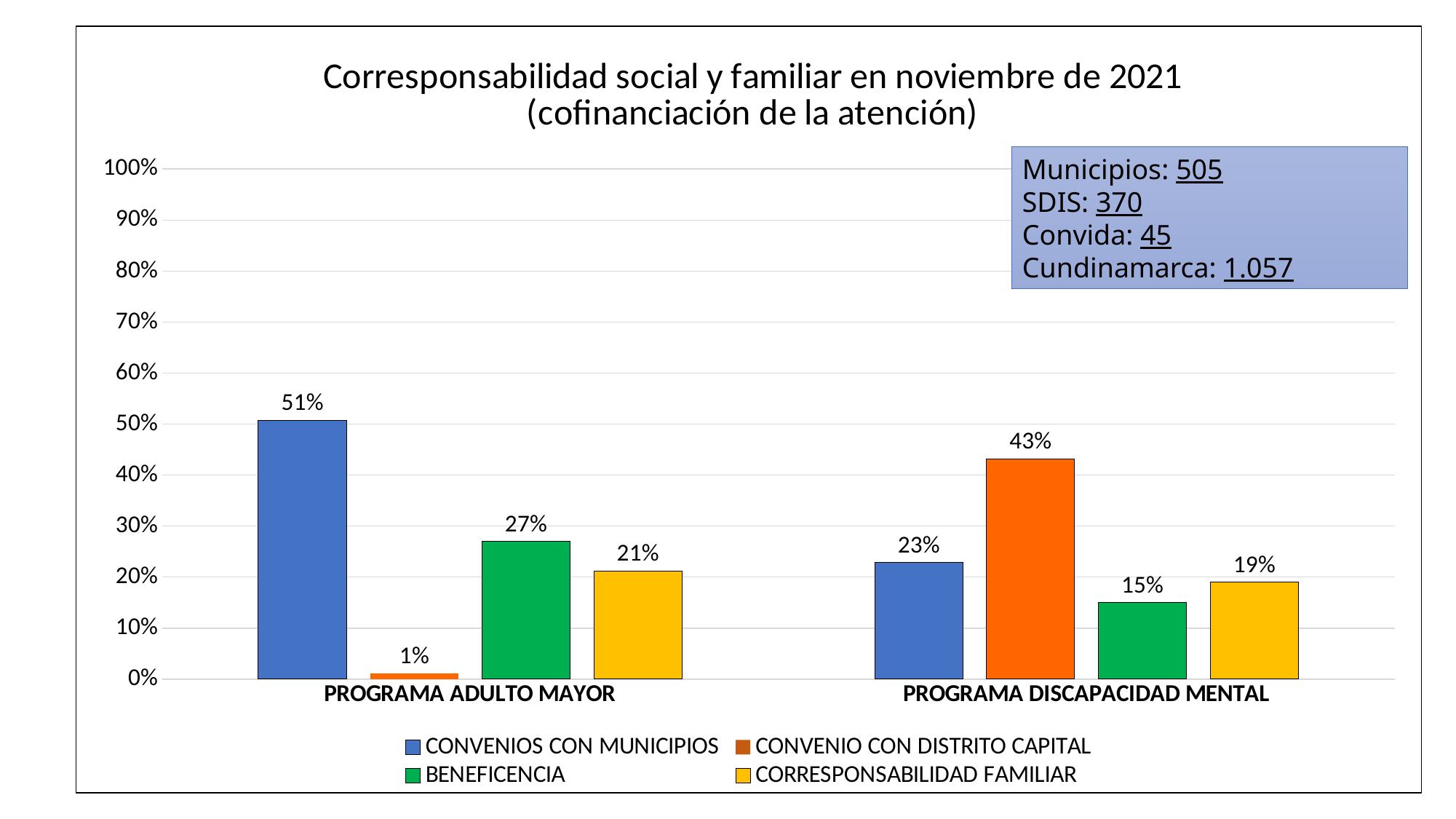
Which series has the highest value in PROGRAMA ADULTO MAYOR? CONVENIOS CON MUNICIPIOS What is the value for CONVENIOS CON MUNICIPIOS in PROGRAMA ADULTO MAYOR? 51% What is the value for CORRESPONSABILIDAD FAMILIAR in PROGRAMA DISCAPACIDAD MENTAL? 19% What is the value for CONVENIO CON DISTRITO CAPITAL in PROGRAMA DISCAPACIDAD MENTAL? 43% How many categories are shown on the x axis? 2 What is the value for BENEFICENCIA in PROGRAMA ADULTO MAYOR? 27% What is the difference between CONVENIOS CON MUNICIPIOS in PROGRAMA ADULTO MAYOR and in PROGRAMA DISCAPACIDAD MENTAL? 28% What value is given for Cundinamarca in the text box on the chart? 1.057 Which series has the lowest value in PROGRAMA DISCAPACIDAD MENTAL? BENEFICENCIA How many series does the legend list? 4 Which is larger: BENEFICENCIA in PROGRAMA ADULTO MAYOR or CORRESPONSABILIDAD FAMILIAR in PROGRAMA ADULTO MAYOR? BENEFICENCIA What kind of chart is shown on the slide? Bar chart